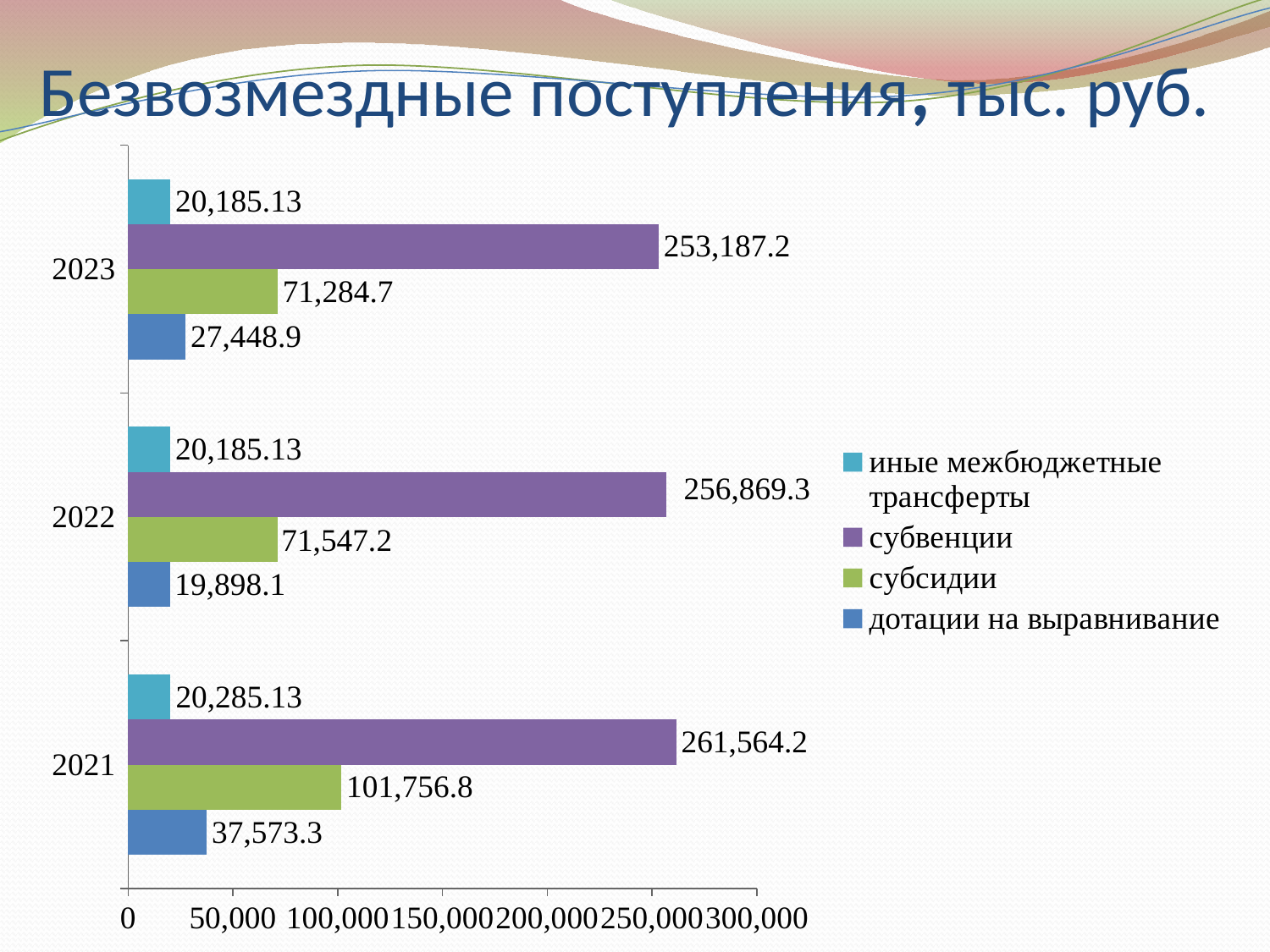
What is the value for субсидии in 2021? 101,756.8 What is the difference between the субсидии values for 2021 and 2022? 30,209.6 In which year is the value for субвенции the highest? 2021 Do the values for субвенции rise or fall from 2021 to 2023? fall Which is larger: субсидии in 2023 or дотации на выравнивание in 2023? субсидии in 2023 What kind of chart is shown on the slide? bar chart What is the value for иные межбюджетные трансферты in 2021? 20,285.13 How many series does the legend list? 4 What is the difference between the дотации на выравнивание values for 2021 and 2022? 17,675.2 In which year is the value for дотации на выравнивание the lowest? 2022 What is the value for дотации на выравнивание in 2022? 19,898.1 What is the value for субвенции in 2023? 253,187.2